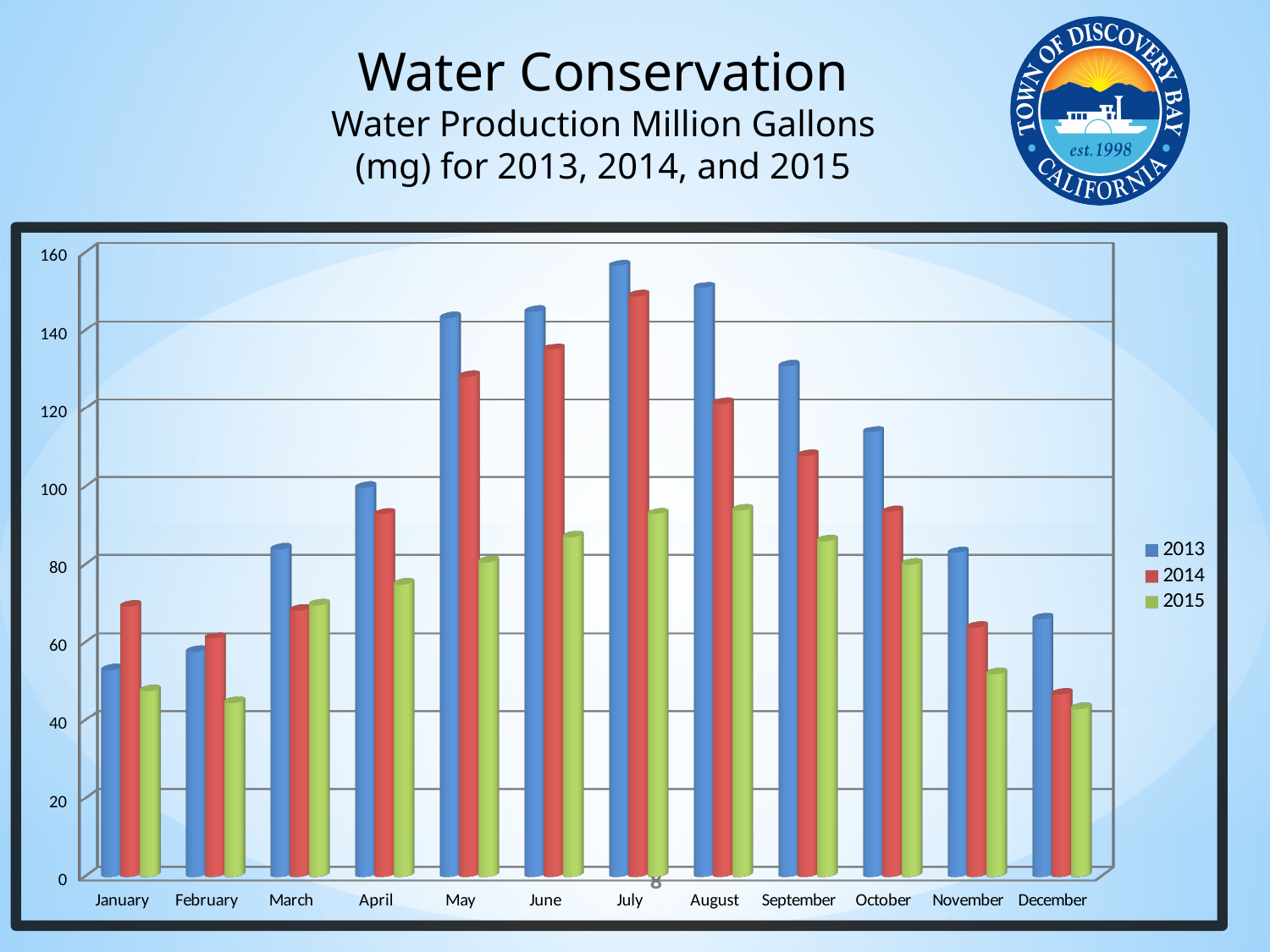
Is the value for May 2014 greater or less than 120? greater Which month has the highest value for 2013? July Is the value for December 2015 greater or less than 60? less How many series does the legend list? 3 Is the value for July 2013 greater or less than 140? greater In September, which is larger, the value for 2013 or the value for 2015? 2013 Which month has the highest value for 2014? July Which series is shown in green in the legend? 2015 In January, which is larger, the value for 2013 or the value for 2014? 2014 How many months are shown on the x axis? 12 What kind of chart is shown on the slide? bar chart Which month has the lowest value for 2014? December